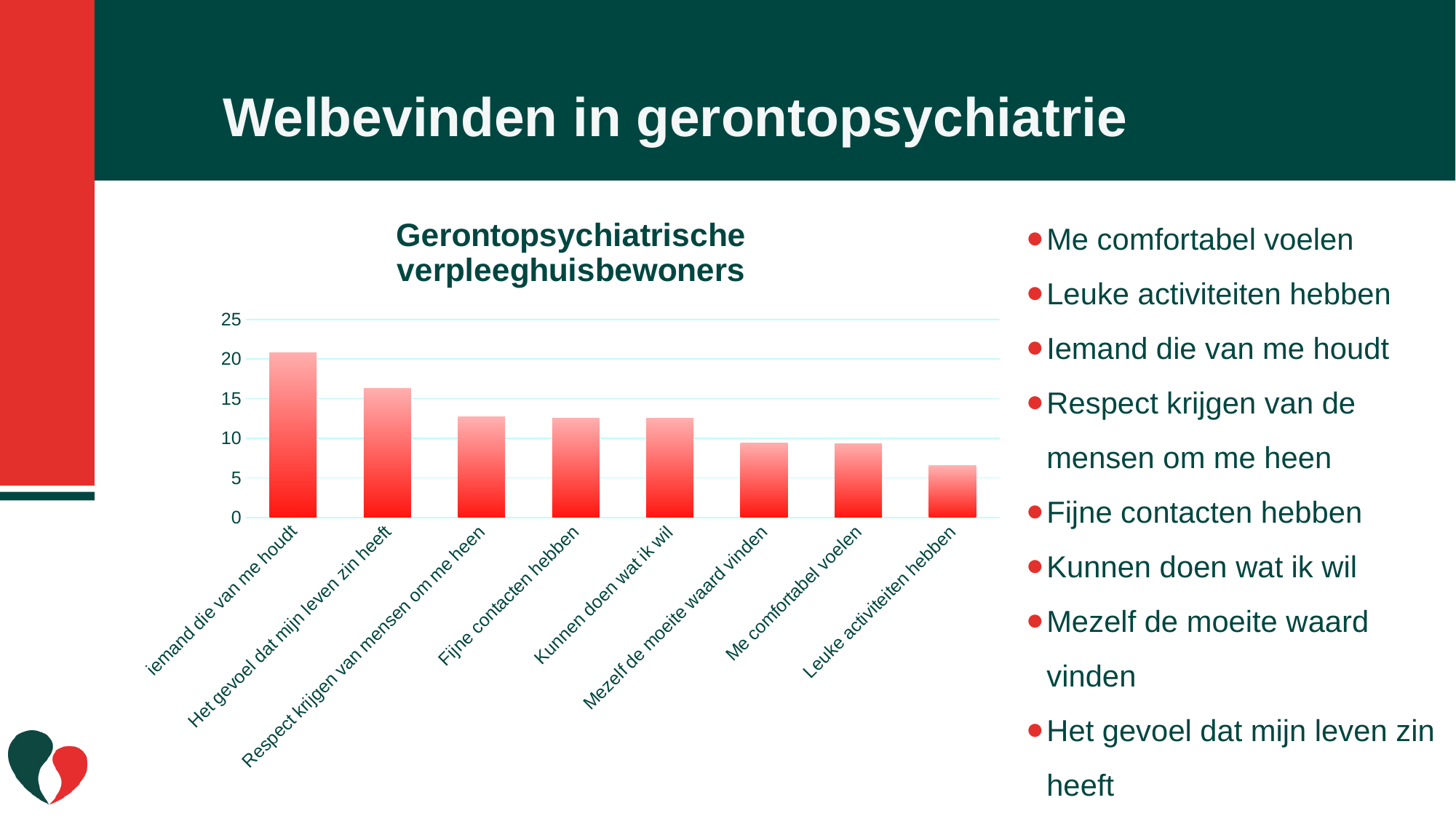
Is the value for 'Het gevoel dat mijn leven zin heeft' greater or less than 15? greater What kind of chart is shown on the slide? bar chart Which category has the lowest value in the chart? Leuke activiteiten hebben Is the value for 'Leuke activiteiten hebben' greater or less than 10? less Which is larger: the value for 'Het gevoel dat mijn leven zin heeft' or the value for 'Fijne contacten hebben'? Het gevoel dat mijn leven zin heeft Which category has the highest value in the chart? iemand die van me houdt Which is larger: the value for 'Leuke activiteiten hebben' or the value for 'Respect krijgen van mensen om me heen'? Respect krijgen van mensen om me heen Is the value for 'Me comfortabel voelen' greater or less than 10? less Do the bar values rise or fall from left to right along the x axis? fall How many categories are plotted in the chart? 8 What is the title of the chart? Gerontopsychiatrische verpleeghuisbewoners